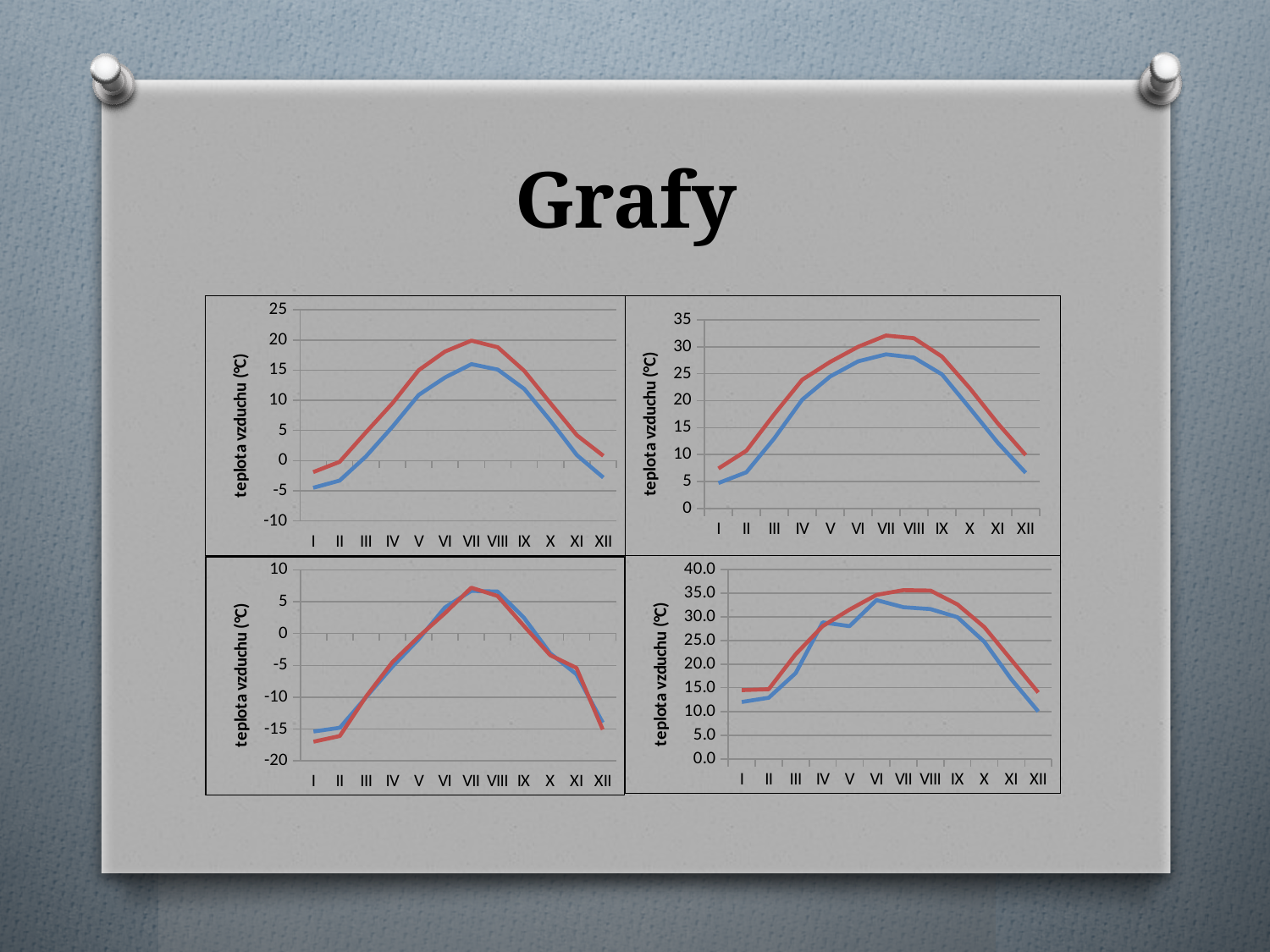
In the top-right chart, is the value of the red line for month VII greater or less than 30? greater What kind of chart is the top-left chart on the slide? line chart What is the y-axis label of the bottom-right chart? teplota vzduchu (°C) In the bottom-right chart, is the value of the blue line for month XII greater or less than 15.0? less In the top-right chart, which line is higher in month VII, the red line or the blue line? red line In the top-left chart, which month has the highest value on the red line? VII In the bottom-left chart, which month has the lowest value on the red line? I In the top-left chart, is the value of the red line for month VII greater or less than 15? greater How many months (categories) are plotted along the x axis of the top-right chart? 12